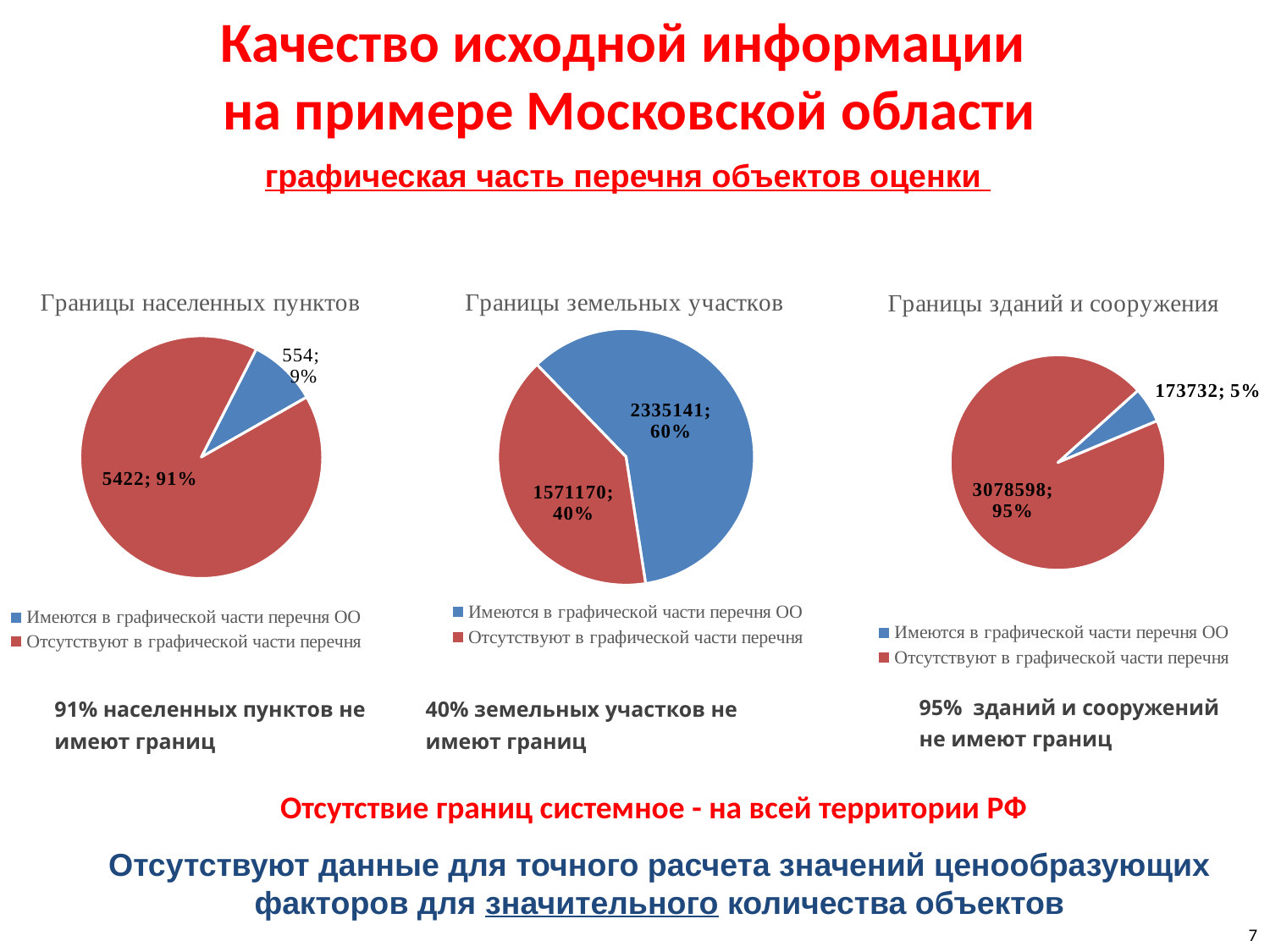
In the chart titled "Границы зданий и сооружения", what is the difference between the two slice values (3078598 and 173732)? 2904866 How many slices does the chart titled "Границы населенных пунктов" have? 2 In the chart titled "Границы земельных участков", which slice is larger: "Имеются в графической части перечня ОО" or "Отсутствуют в графической части перечня"? Имеются в графической части перечня ОО In the chart titled "Границы населенных пунктов", what is the difference between the two slice values (5422 and 554)? 4868 In the chart titled "Границы зданий и сооружения", what value is shown for "Имеются в графической части перечня ОО"? 173732; 5% What type of chart is used for "Границы земельных участков"? Pie chart In the chart titled "Границы зданий и сооружения", which slice is the largest? Отсутствуют в графической части перечня In the chart titled "Границы земельных участков", what value is shown for "Имеются в графической части перечня ОО"? 2335141; 60% In the chart titled "Границы земельных участков", what share of the pie does "Отсутствуют в графической части перечня" take? 40% In the chart titled "Границы населенных пунктов", what share of the pie does "Имеются в графической части перечня ОО" take? 9% In the chart titled "Границы населенных пунктов", what value is shown for the slice "Отсутствуют в графической части перечня"? 5422; 91% How many entries does the legend of the chart titled "Границы зданий и сооружения" list? 2